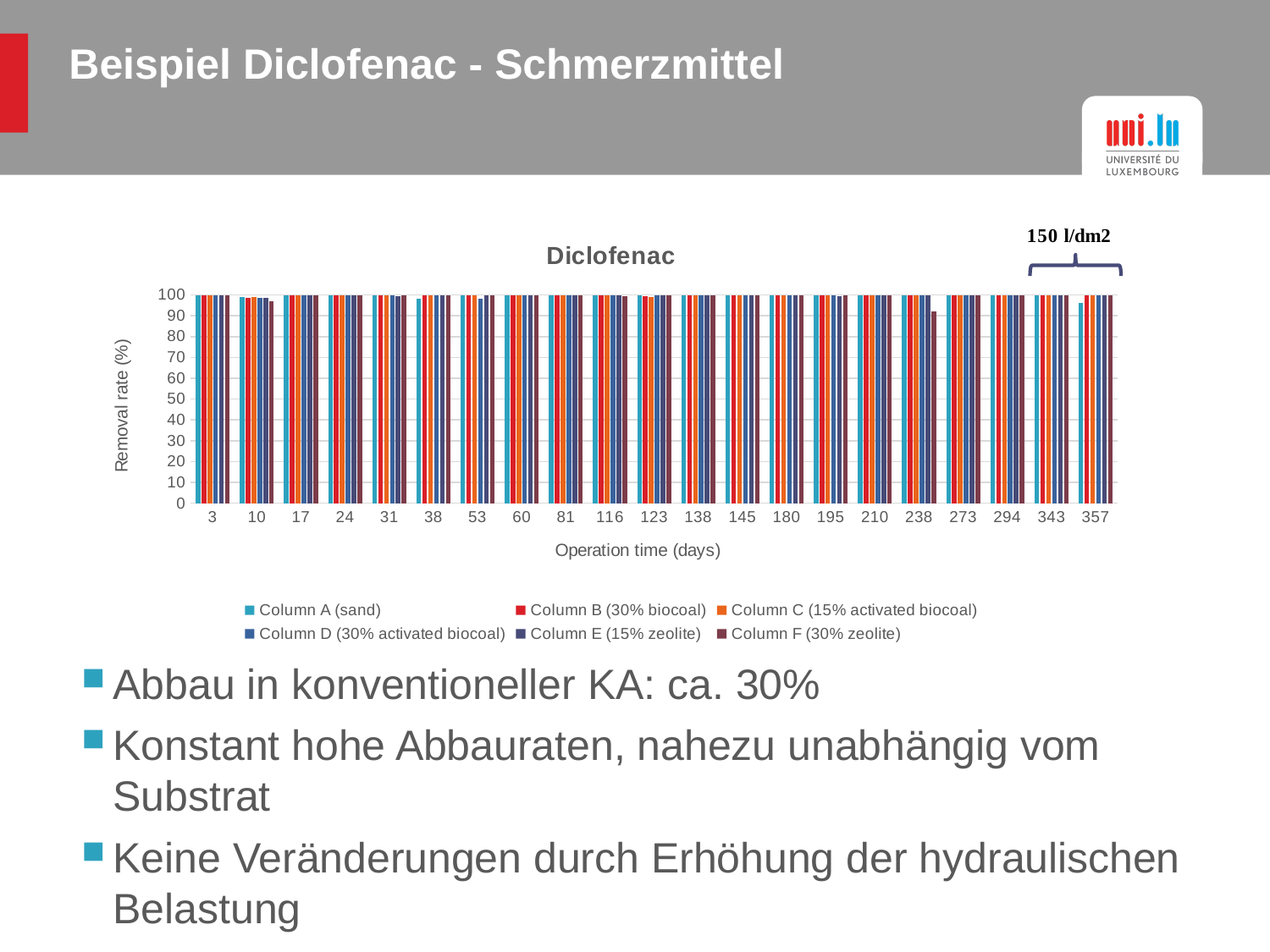
Is the value for Column E (15% zeolite) at 116 days greater or less than 70? greater How many series does the chart legend list? 6 What is the title of the chart? Diclofenac Is the value for Column F (30% zeolite) at 238 days greater or less than 80? greater Is the value for Column B (30% biocoal) at 357 days greater or less than 50? greater How many operation time categories are shown on the x axis of the chart? 21 Which is larger at 238 days: the value for Column A (sand) or the value for Column F (30% zeolite)? Column A (sand) What is the highest value shown on the y axis of the chart? 100 What is the label of the y axis of the chart? Removal rate (%) What type of chart is shown on the slide? bar chart